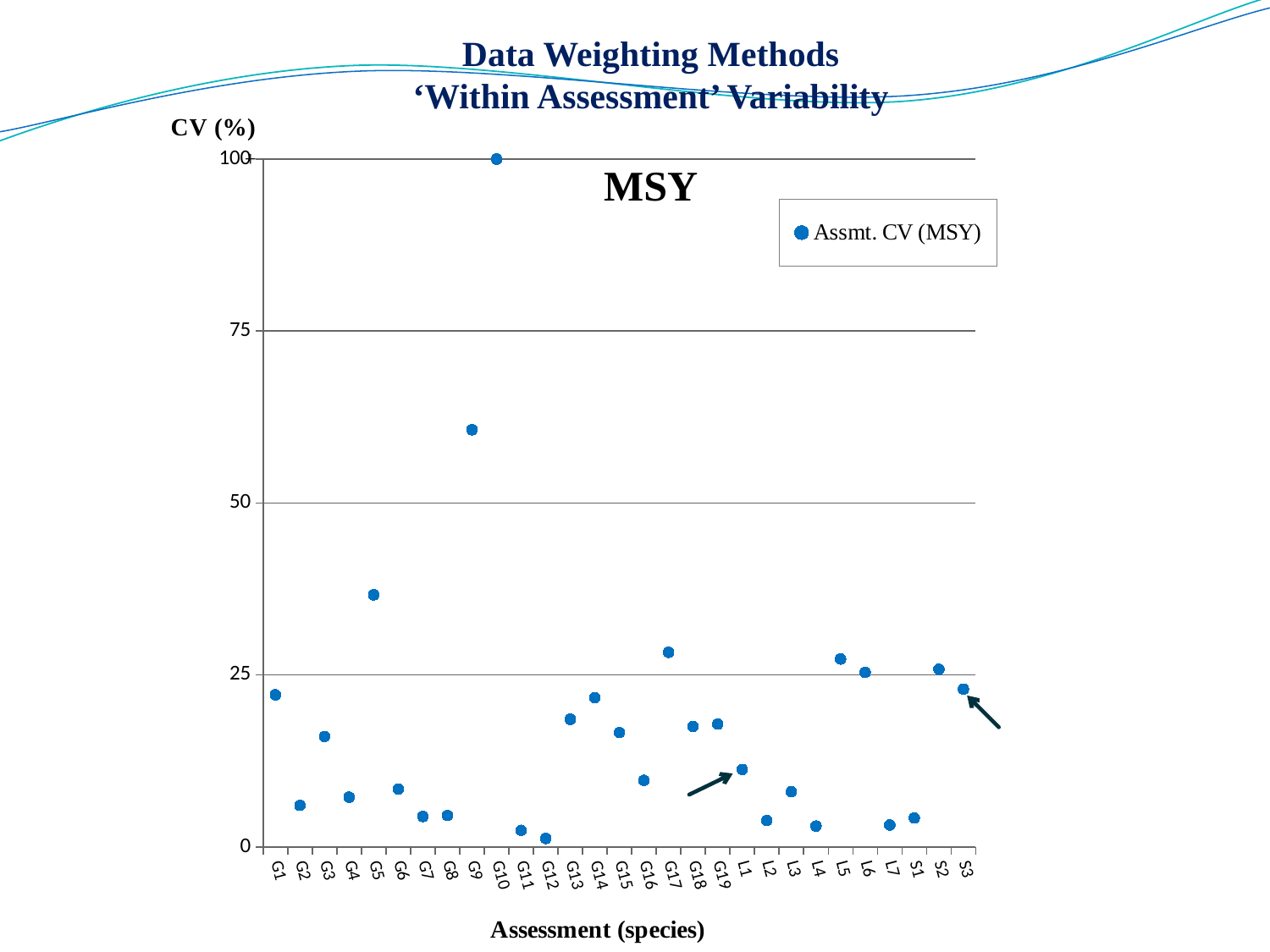
What is the CV (%) value for G10? 100 How many series does the legend list? 1 Which has the larger CV (%) value, G9 or G5? G9 Is the value for G9 greater or less than 50? greater Is the value for G17 greater or less than 25? greater What kind of chart is shown on the slide? scatter chart Which assessment has the highest CV (%) value? G10 Is the value for L2 greater or less than 25? less What is the legend entry for the plotted series? Assmt. CV (MSY) How many assessments (categories) are plotted along the x axis? 29 Which has the larger CV (%) value, G1 or G2? G1